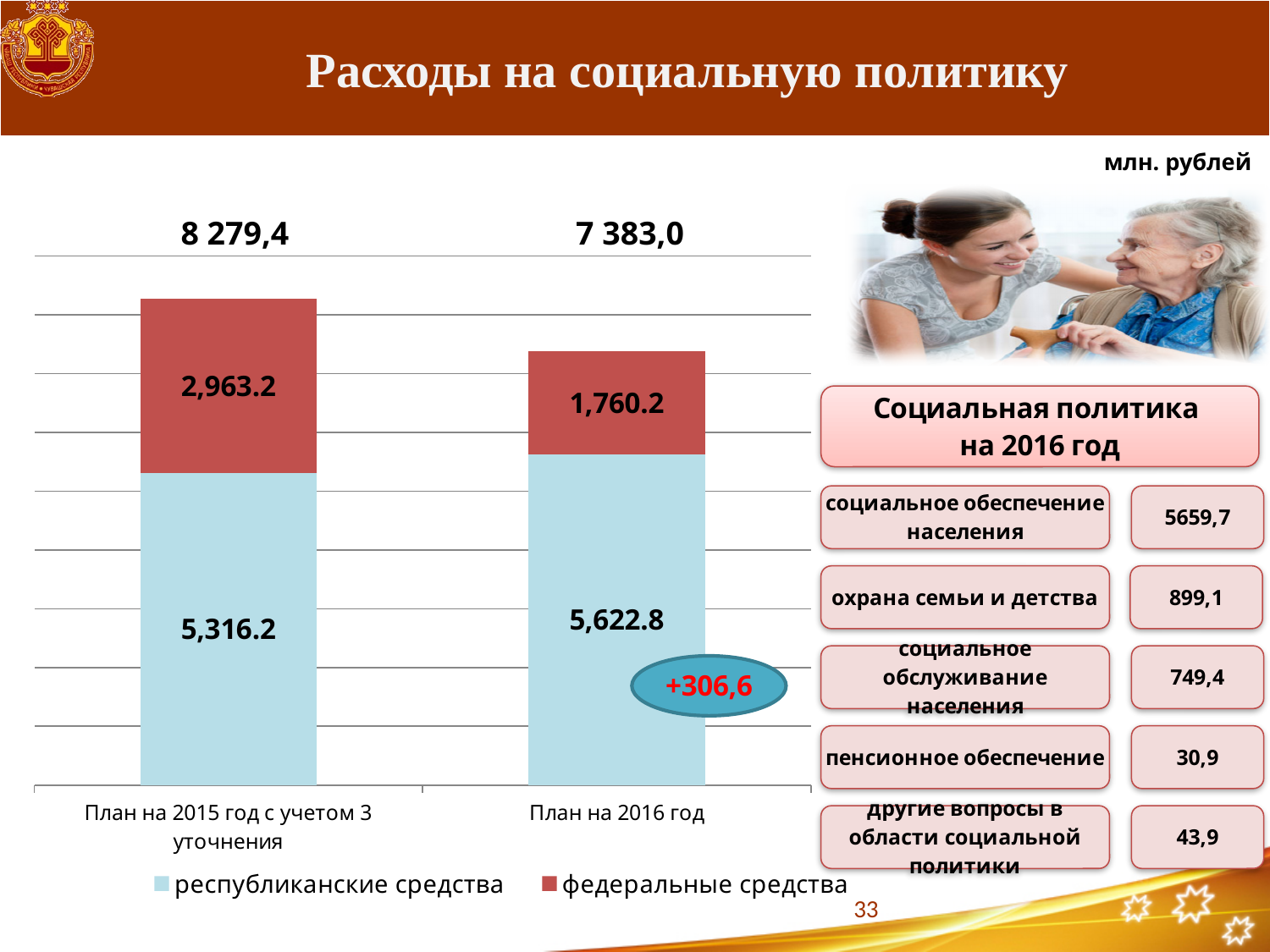
What is the total shown above the stacked bar for План на 2016 год? 7 383,0 What is the value of федеральные средства for План на 2016 год? 1,760.2 Which category has the higher value for республиканские средства? План на 2016 год What is the difference between федеральные средства in План на 2015 год с учетом 3 уточнения and План на 2016 год? 1,203.0 What kind of chart is shown on the slide? Stacked bar chart What is the total shown above the stacked bar for План на 2015 год с учетом 3 уточнения? 8 279,4 What is the value of республиканские средства for План на 2016 год? 5,622.8 What is the value of федеральные средства for План на 2015 год с учетом 3 уточнения? 2,963.2 How many series does the chart legend list? 2 Which category has the higher value for федеральные средства? План на 2015 год с учетом 3 уточнения What is the value of республиканские средства for План на 2015 год с учетом 3 уточнения? 5,316.2 How many categories are shown on the x axis of the chart? 2